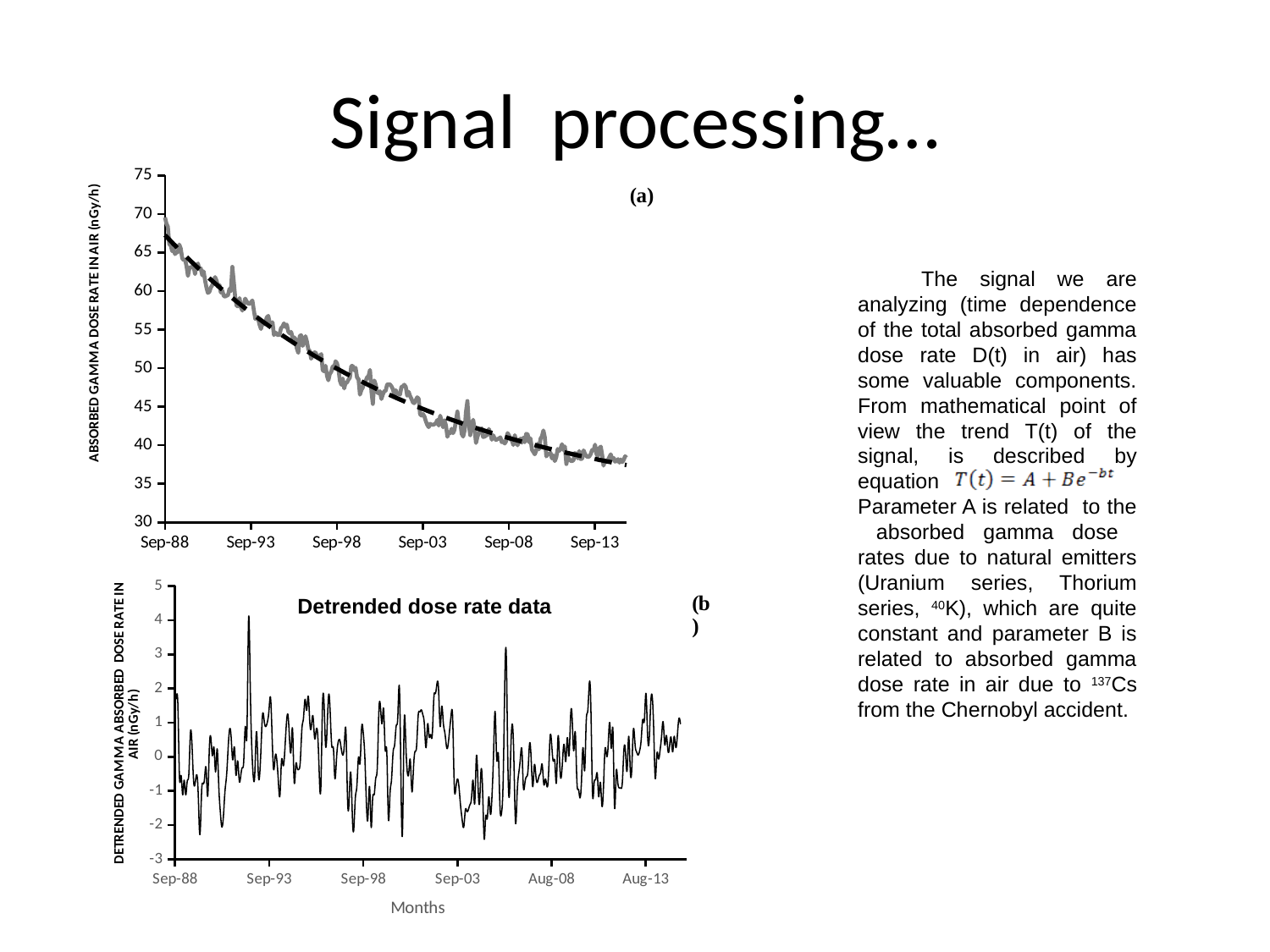
In the top chart (a), is the absorbed gamma dose rate at Sep-88 greater or less than 65? greater In the top chart (a), which is larger: the dose rate at Sep-93 or at Sep-08? Sep-93 What kind of chart is the top chart labelled (a)? line chart In the bottom chart, is the lowest value of the detrended dose rate greater or less than -2? less In the top chart (a), is the absorbed gamma dose rate at Sep-13 greater or less than 40? less What kind of chart is the bottom chart titled 'Detrended dose rate data'? line chart What is the x-axis label of the bottom chart? Months What is the title of the bottom chart? Detrended dose rate data In the top chart (a), do the absorbed gamma dose rate values rise or fall from Sep-88 to Sep-13? fall